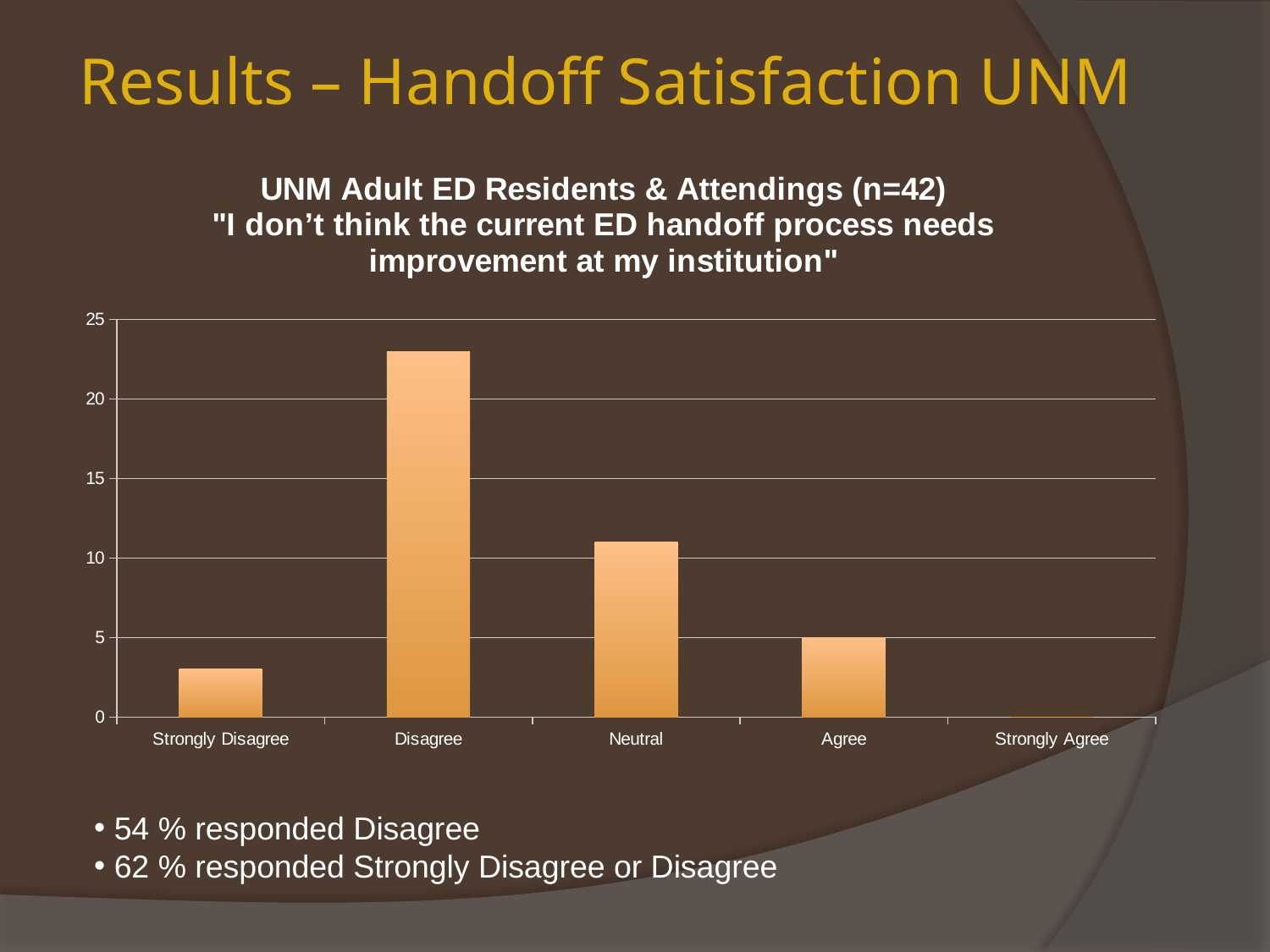
How many response categories are shown on the x axis of the chart? 5 Is the value for Strongly Disagree greater or less than 5? less Is the value for Neutral greater or less than 10? greater Which response category has the lowest value? Strongly Agree What is the highest value shown on the y axis of the chart? 25 Is the value for Disagree greater or less than 20? greater What is the value for Strongly Agree? 0 Which response category has the highest bar? Disagree What is the value for Agree? 5 Which is larger, the value for Neutral or the value for Agree? Neutral What kind of chart is shown on the slide? bar chart Which is larger, the value for Strongly Disagree or the value for Disagree? Disagree